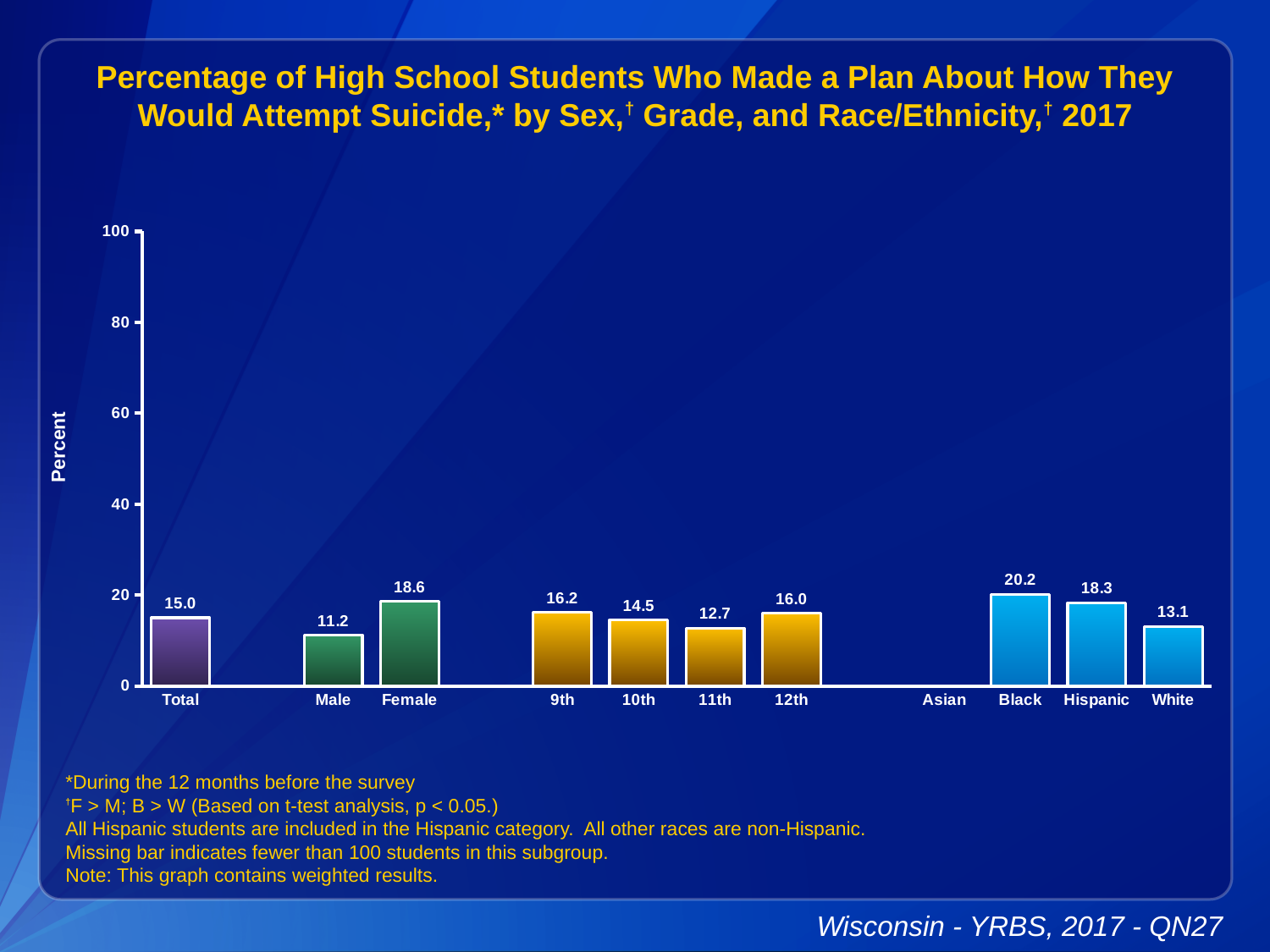
Which category has the lowest value among those with a bar? Male What is the value for Female? 18.6 What is the value for Black students? 20.2 How many categories have a bar plotted on the chart? 11 What is the value for 11th grade? 12.7 What is the Total value shown on the chart? 15.0 Which category on the x axis has no bar? Asian Which is larger, the value for 9th grade or 12th grade? 9th Is the value for Hispanic greater or less than 20? less What is the difference between the Female and Male values? 7.4 What kind of chart is shown? bar chart Which category has the highest value? Black